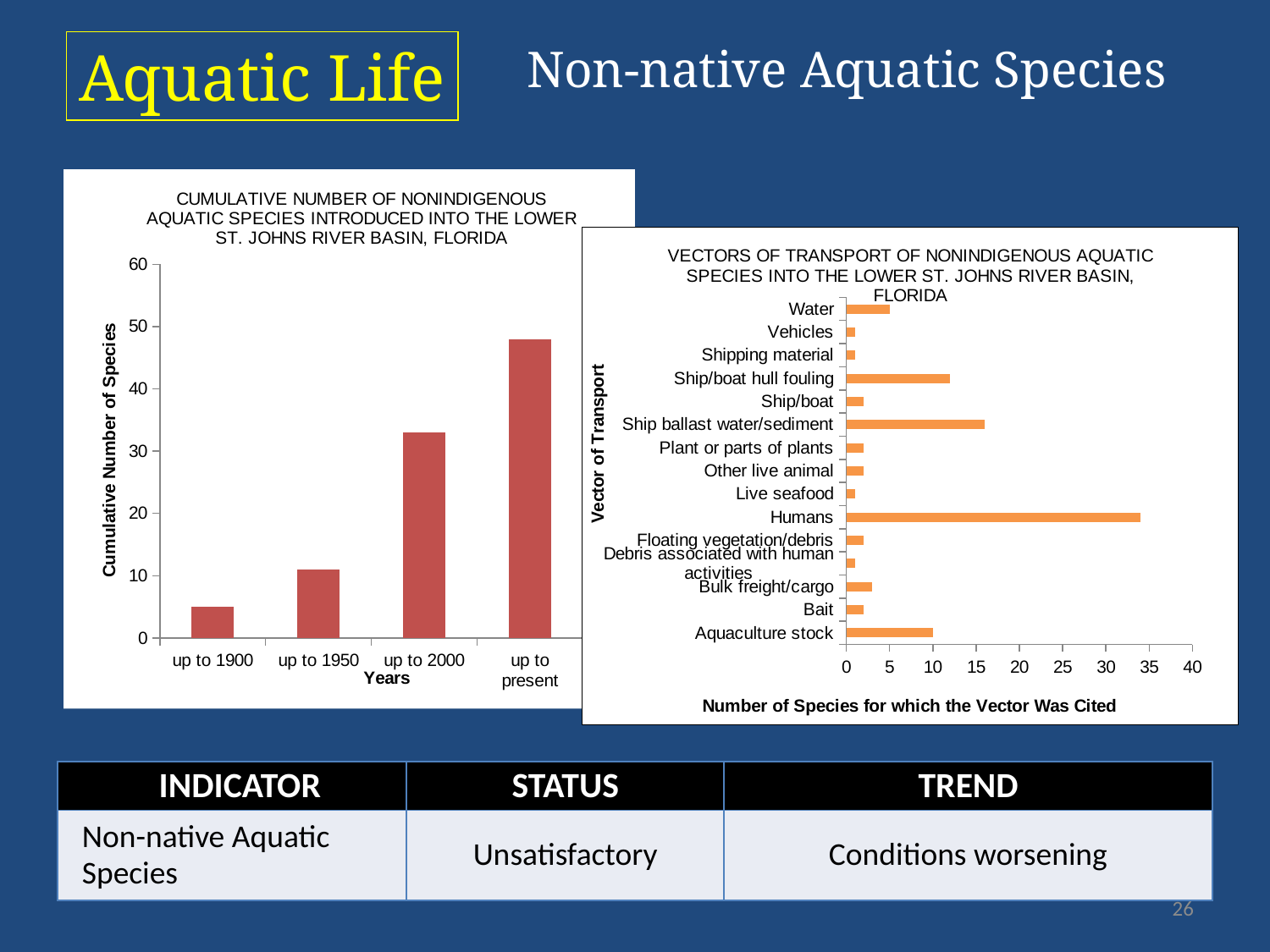
In the right chart (vectors of transport of nonindigenous aquatic species), which vector was cited for the most species? Humans In the left chart (cumulative number of nonindigenous aquatic species), is the value for 'up to present' greater or less than 40? greater What type of chart is the left chart, 'Cumulative Number of Nonindigenous Aquatic Species Introduced into the Lower St. Johns River Basin, Florida'? Bar chart In the right chart (vectors of transport of nonindigenous aquatic species), is the value for Humans greater or less than 30? greater In the left chart (cumulative number of nonindigenous aquatic species), which period has the highest cumulative number of species? up to present In the right chart (vectors of transport of nonindigenous aquatic species), which is larger: the value for Ship ballast water/sediment or the value for Water? Ship ballast water/sediment In the left chart (cumulative number of nonindigenous aquatic species), do the values rise or fall from 'up to 1900' to 'up to present'? Rise What is the x-axis label of the right chart (vectors of transport of nonindigenous aquatic species)? Number of Species for which the Vector Was Cited In the left chart (cumulative number of nonindigenous aquatic species), which period has the lowest cumulative number of species? up to 1900 In the right chart (vectors of transport of nonindigenous aquatic species), how many vectors of transport are listed on the y axis? 15 In the left chart (cumulative number of nonindigenous aquatic species), is the value for 'up to 1950' greater or less than 20? less In the left chart (cumulative number of nonindigenous aquatic species), how many time-period categories are shown on the x axis? 4